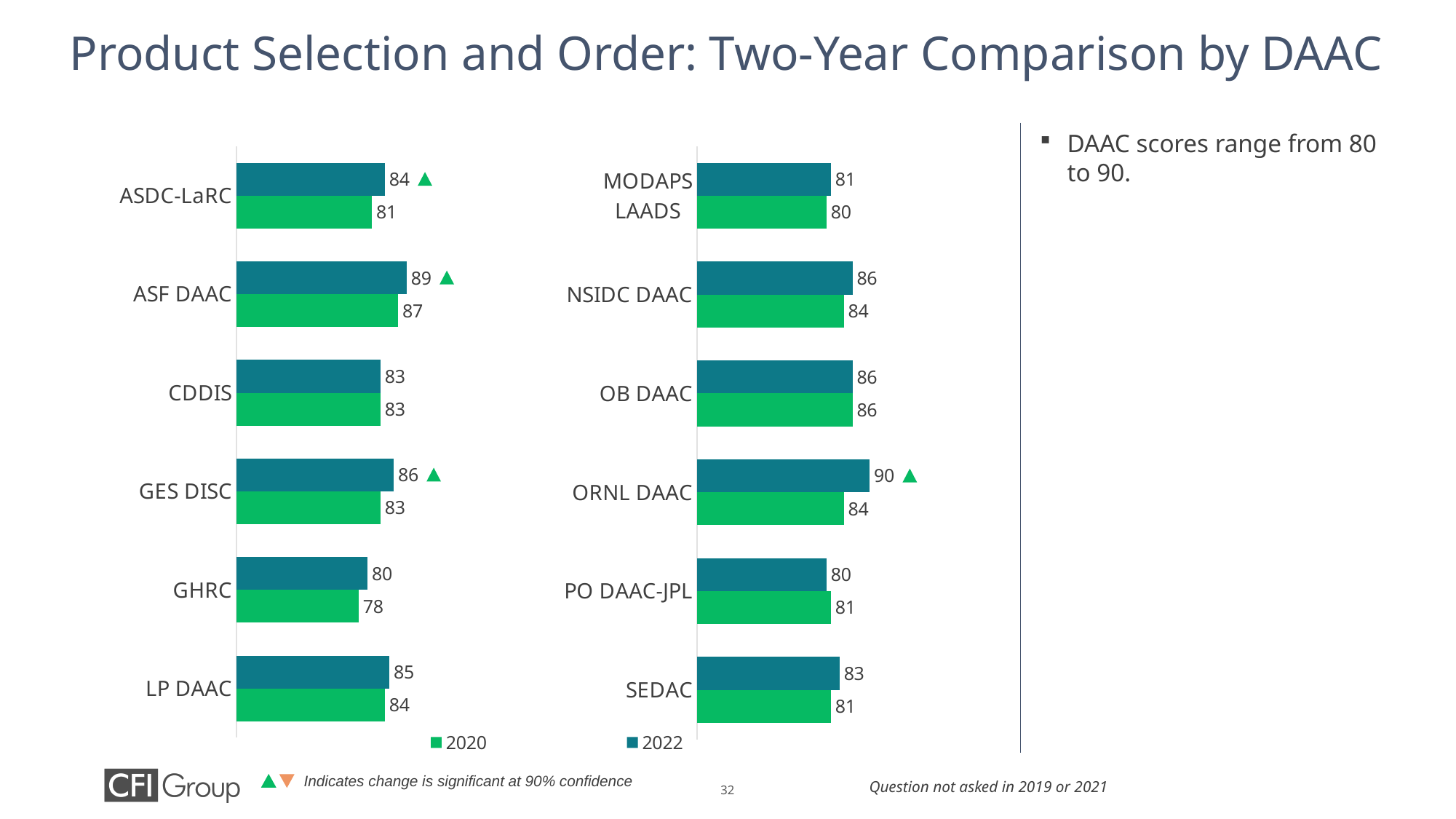
In the right chart, what is the 2020 score for ORNL DAAC? 84 What type of chart is used on this slide? Bar chart In the left chart, what is the 2022 score for ASF DAAC? 89 In the right chart, which is larger for PO DAAC-JPL: the 2020 score or the 2022 score? 2020 How many DAACs are shown in the left chart? 6 In the left chart, which DAAC has the lowest 2020 score? GHRC Which colour represents the 2020 series in the legend? Green In the left chart, what is the 2020 score for GHRC? 78 How many series does the legend list? 2 In the left chart, what is the difference between the 2022 and 2020 scores for GES DISC? 3 In the right chart, what is the difference between the 2022 and 2020 scores for ORNL DAAC? 6 In the right chart, which DAAC has the highest 2022 score? ORNL DAAC